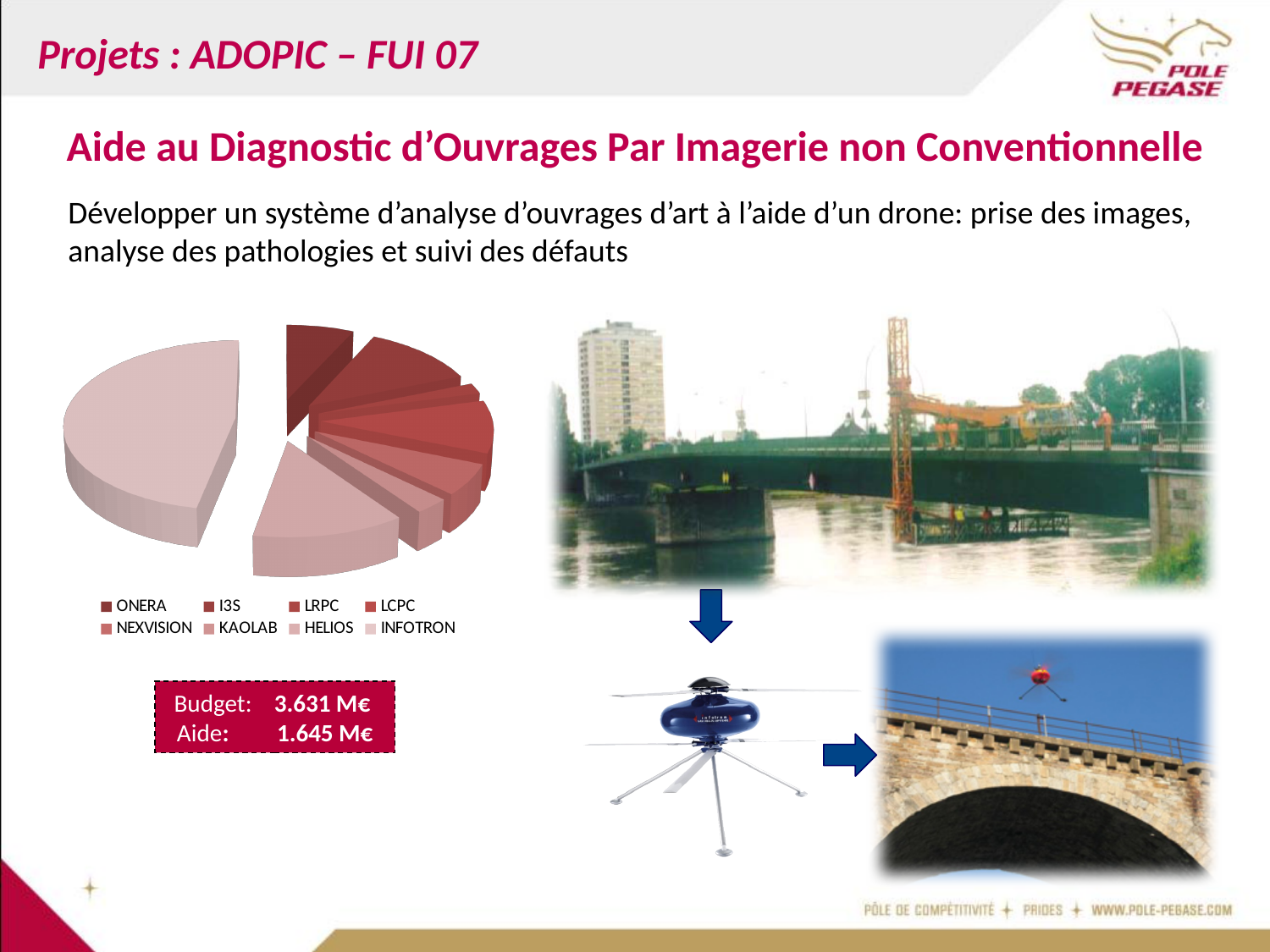
Which slice is larger in the pie chart, INFOTRON or ONERA? INFOTRON How many entries does the legend of the pie chart list? 8 Which category has the largest slice in the pie chart? INFOTRON Which legend entry of the pie chart is listed first? ONERA Which slice is larger in the pie chart, INFOTRON or LRPC? INFOTRON How many slices does the pie chart have? 8 What kind of chart is shown on the slide? pie chart Which legend entry of the pie chart is listed last? INFOTRON Which slice is larger in the pie chart, KAOLAB or LCPC? LCPC